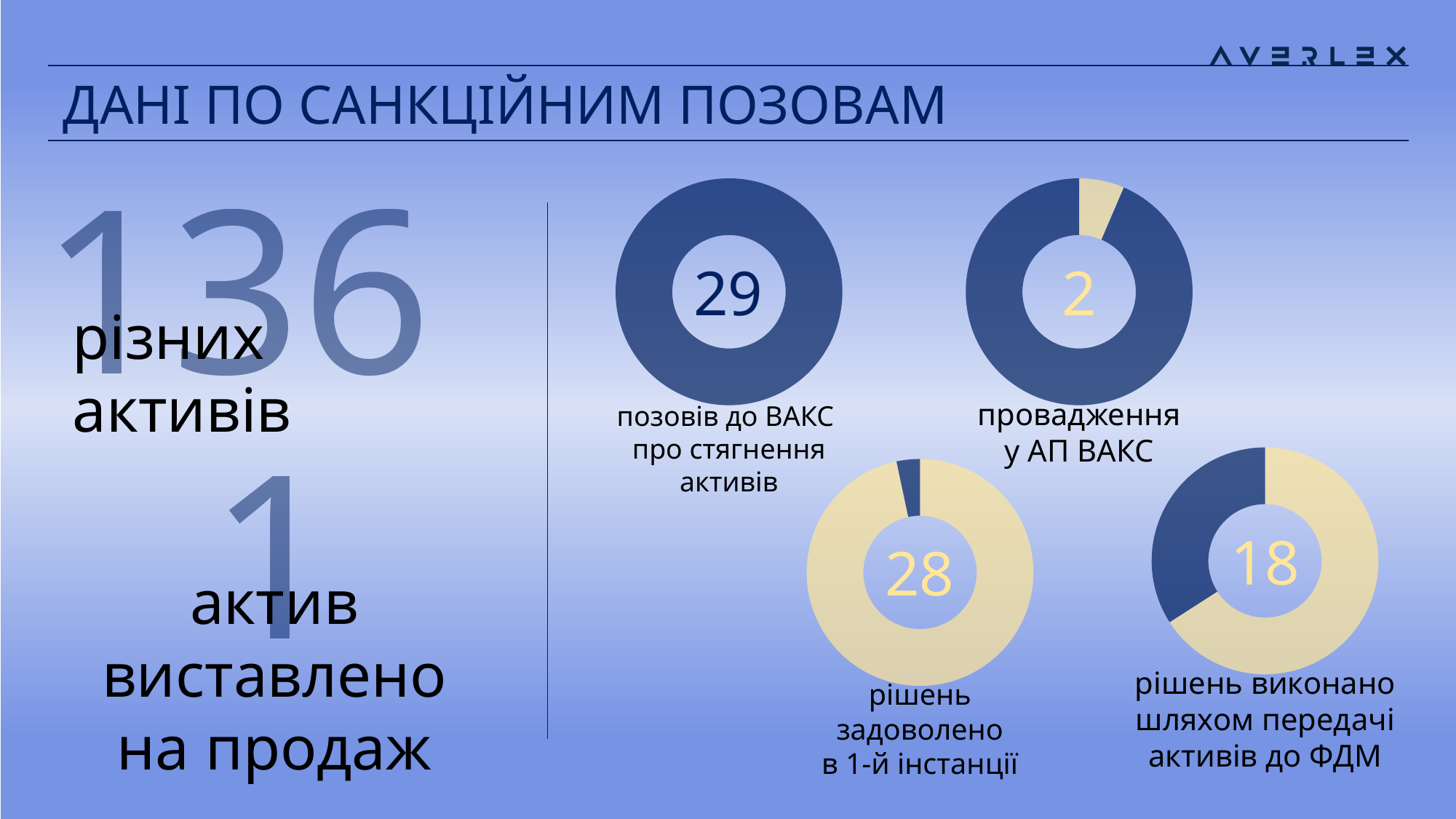
Which donut chart shows the lowest central number? провадження у АП ВАКС (2) How many donut charts are shown on the slide? 4 Which is larger: the number of "рішень виконано шляхом передачі активів до ФДМ" or the number of "провадження у АП ВАКС"? рішень виконано шляхом передачі активів до ФДМ (18) What number is shown in the centre of the donut chart labelled "рішень виконано шляхом передачі активів до ФДМ"? 18 What is the difference between the number of "позовів до ВАКС про стягнення активів" and the number of "рішень задоволено в 1-й інстанції"? 1 What kind of charts are used on the right side of the slide? Donut (pie) charts What is the difference between the number of "рішень задоволено в 1-й інстанції" and the number of "рішень виконано шляхом передачі активів до ФДМ"? 10 What is the title of the slide containing the donut charts? ДАНІ ПО САНКЦІЙНИМ ПОЗОВАМ What number is shown in the centre of the donut chart labelled "рішень задоволено в 1-й інстанції"? 28 What number is shown in the centre of the donut chart labelled "провадження у АП ВАКС"? 2 What number is shown in the centre of the donut chart labelled "позовів до ВАКС про стягнення активів"? 29 Which donut chart shows the highest central number? позовів до ВАКС про стягнення активів (29)